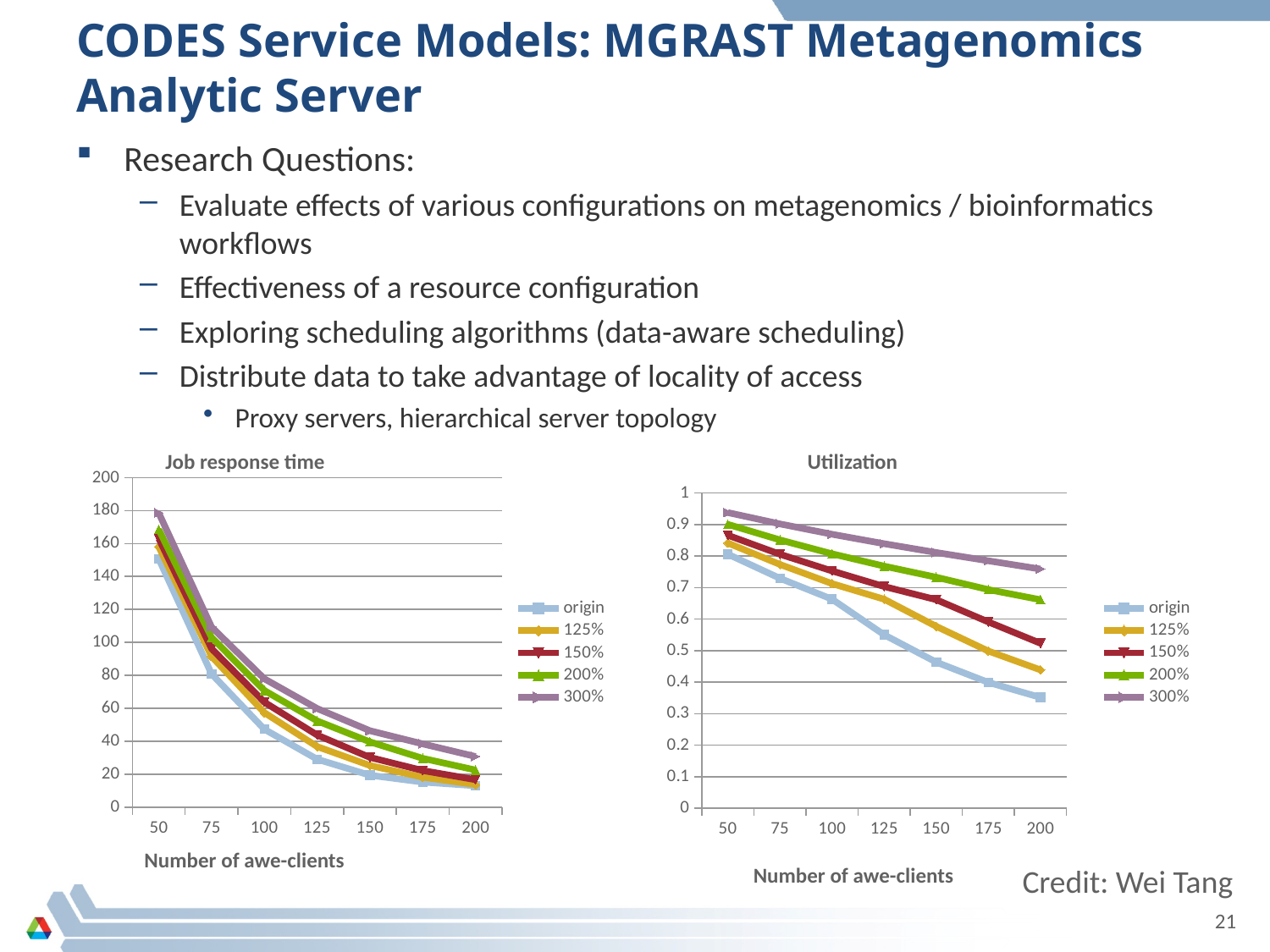
In the Utilization chart, what is the label of the x axis? Number of awe-clients In the Job response time chart, is the value for origin at 200 awe-clients greater or less than 20? less In the Utilization chart, is the value for origin at 200 awe-clients greater or less than 0.4? less In the Job response time chart, do the values rise or fall as the number of awe-clients increases? fall In the Utilization chart, do the values rise or fall as the number of awe-clients increases? fall In the Utilization chart, how many series does the legend list? 5 In the Job response time chart, is the value for 300% at 50 awe-clients greater or less than 160? greater In the Job response time chart, what kind of chart is it? line chart In the Job response time chart, how many points are on the x axis? 7 In the Utilization chart, which series has the highest value at 200 awe-clients? 300% In the Job response time chart, which series has the highest value at 50 awe-clients? 300% In the Job response time chart, which series has the lowest value at 200 awe-clients? origin